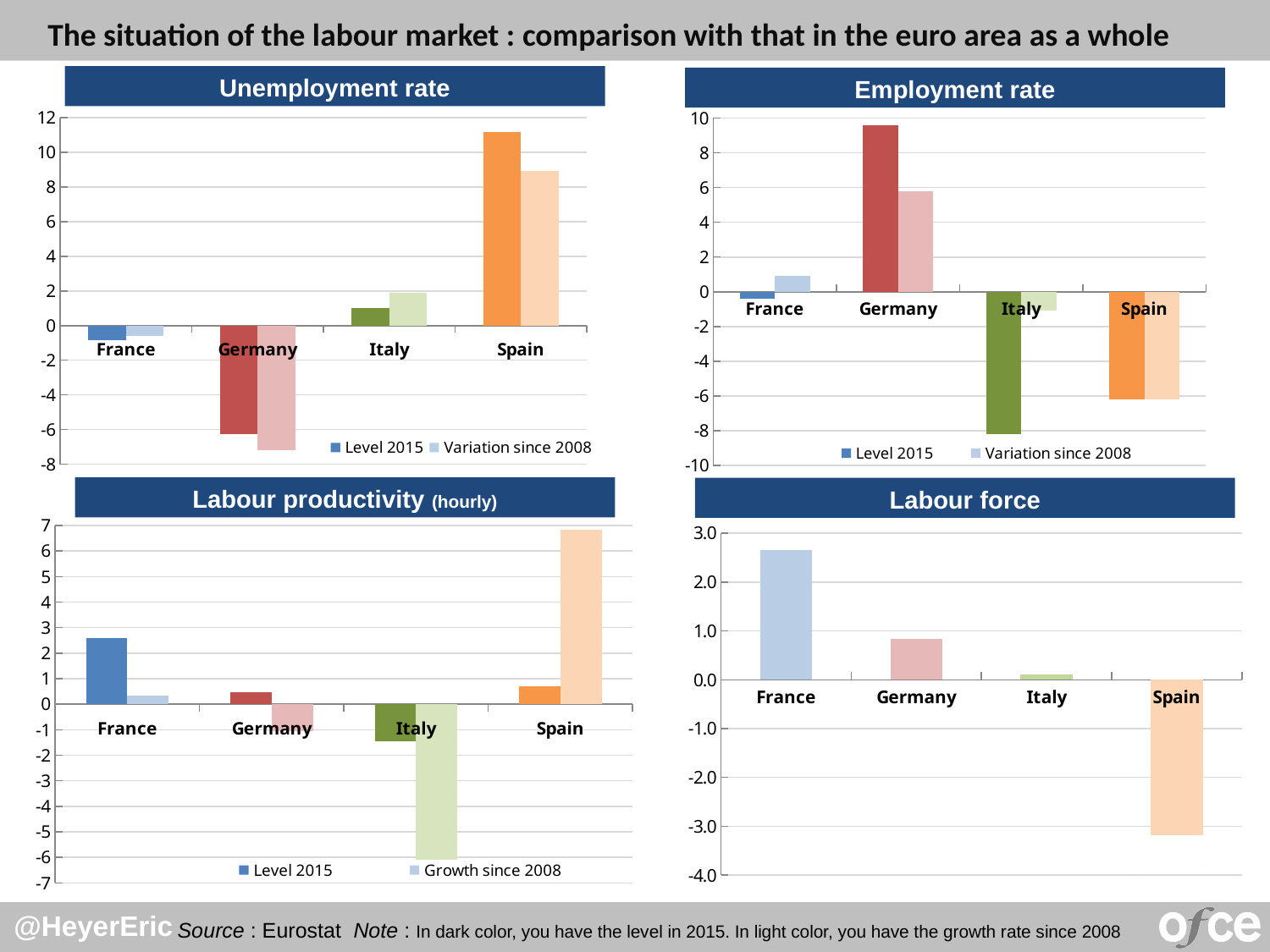
In the Employment rate chart, which country has the lowest Level 2015 value? Italy In the Labour productivity (hourly) chart, what are the two legend entries? Level 2015 and Growth since 2008 In the Unemployment rate chart, which country has the highest Level 2015 value? Spain In the Employment rate chart, is the Level 2015 value for Germany greater or less than 8? greater In the Employment rate chart, which country has the highest Level 2015 value? Germany In the Labour productivity (hourly) chart, which is larger, the Level 2015 value for France or for Germany? France In the Labour force chart, which country has the lowest value? Spain In the Labour force chart, how many countries are shown on the x axis? 4 In the Unemployment rate chart, is the Level 2015 value for Spain greater or less than 10? greater In the Unemployment rate chart, is the Variation since 2008 value for Germany greater or less than -6? less In the Unemployment rate chart, how many series does the legend list? 2